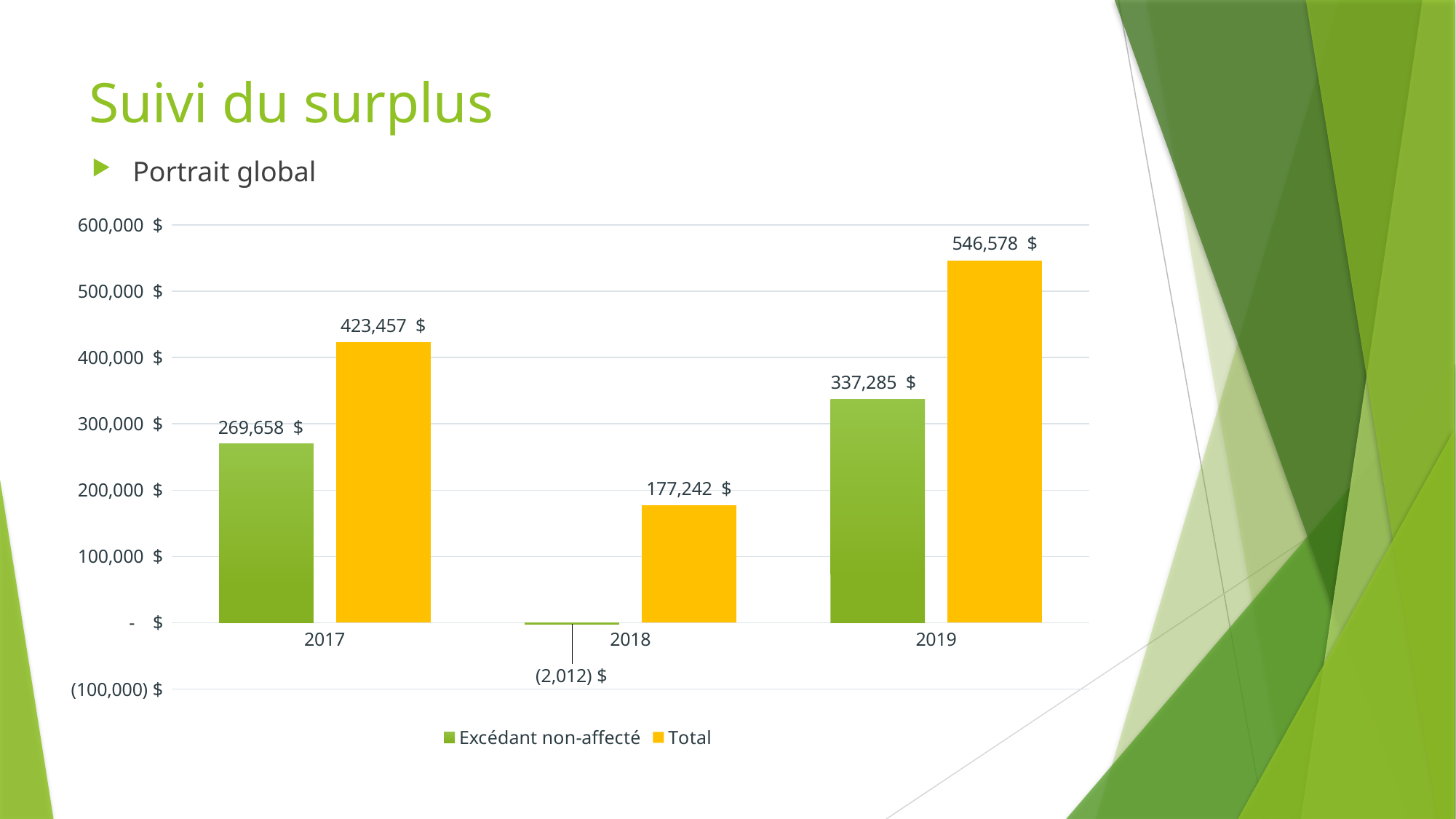
Which year has the highest Total value? 2019 What is the value of Total for 2018? 177,242 $ What is the difference between Total and Excédant non-affecté in 2017? 153,799 $ Which is larger in 2019: Excédant non-affecté or Total? Total What is the value of Excédant non-affecté for 2017? 269,658 $ How many years are shown on the x axis? 3 What kind of chart is shown on the slide? Bar chart How many series does the legend list? 2 What is the value of Total for 2019? 546,578 $ What is the difference between the Total values for 2019 and 2017? 123,121 $ Which year has the lowest Excédant non-affecté value? 2018 What is the value of Excédant non-affecté for 2018? (2,012) $